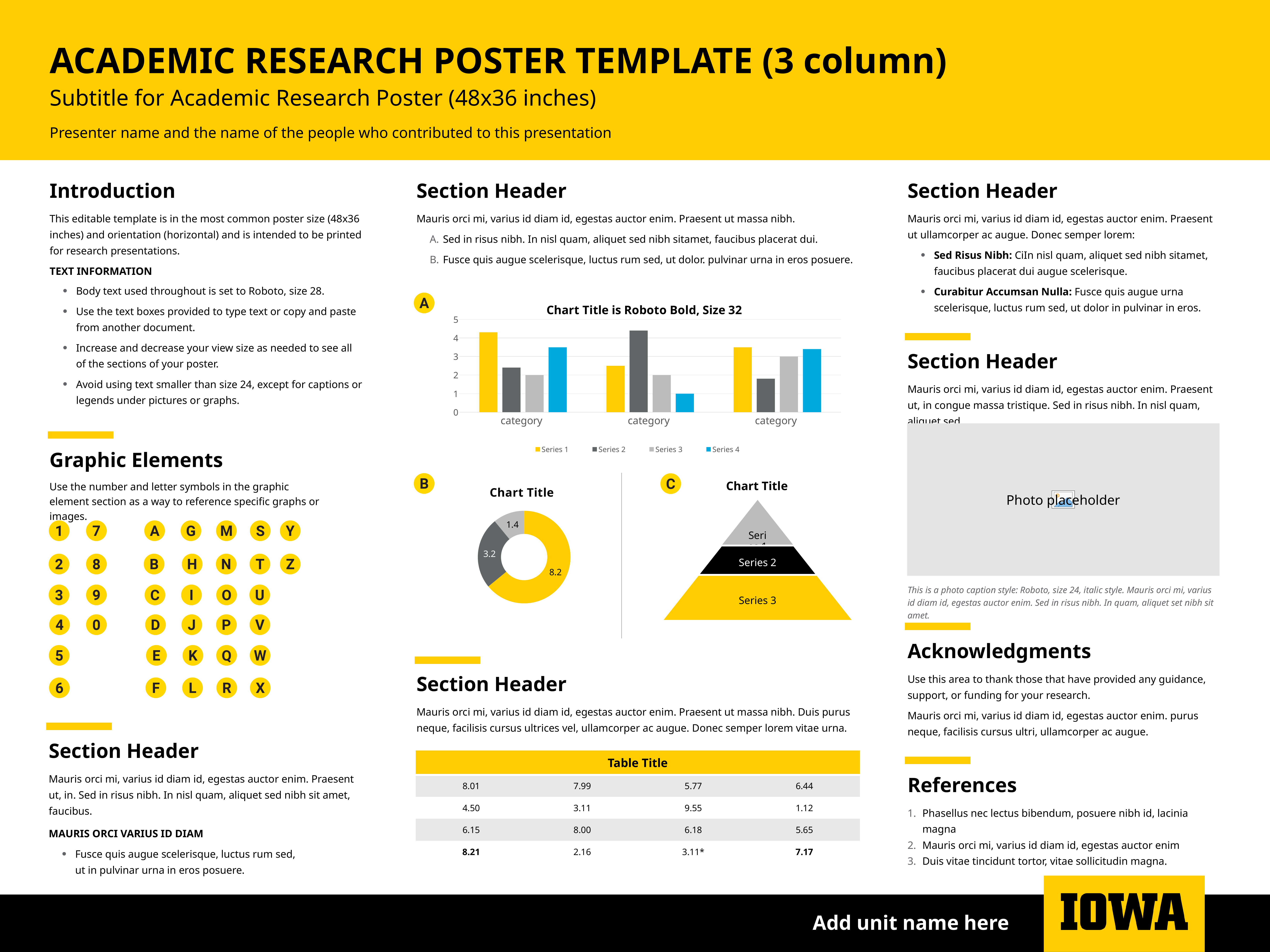
In chart A (the bar chart), is the Series 2 value in the middle category group greater or less than 4? greater In chart A (the bar chart), which series has the tallest bar in the middle category group? Series 2 What kind of chart is chart A, titled "Chart Title is Roboto Bold, Size 32"? bar chart In chart A (the bar chart), is the Series 4 value in the middle category group greater or less than 2? less In chart B (the doughnut chart), what is the difference between the largest slice (8.2) and the slice labelled 3.2? 5.0 In chart A (the bar chart), is the Series 1 value in the leftmost category group greater or less than 4? greater In chart C (the pyramid chart), which series is shown in the bottom level? Series 3 In chart A (the bar chart), how many series does the legend list? 4 In chart B (the doughnut chart), what is the value of the largest slice? 8.2 In chart A (the bar chart), how many category groups are shown on the x axis? 3 In chart A (the bar chart), what colour are the Series 1 bars? yellow What kind of chart is chart B? doughnut chart